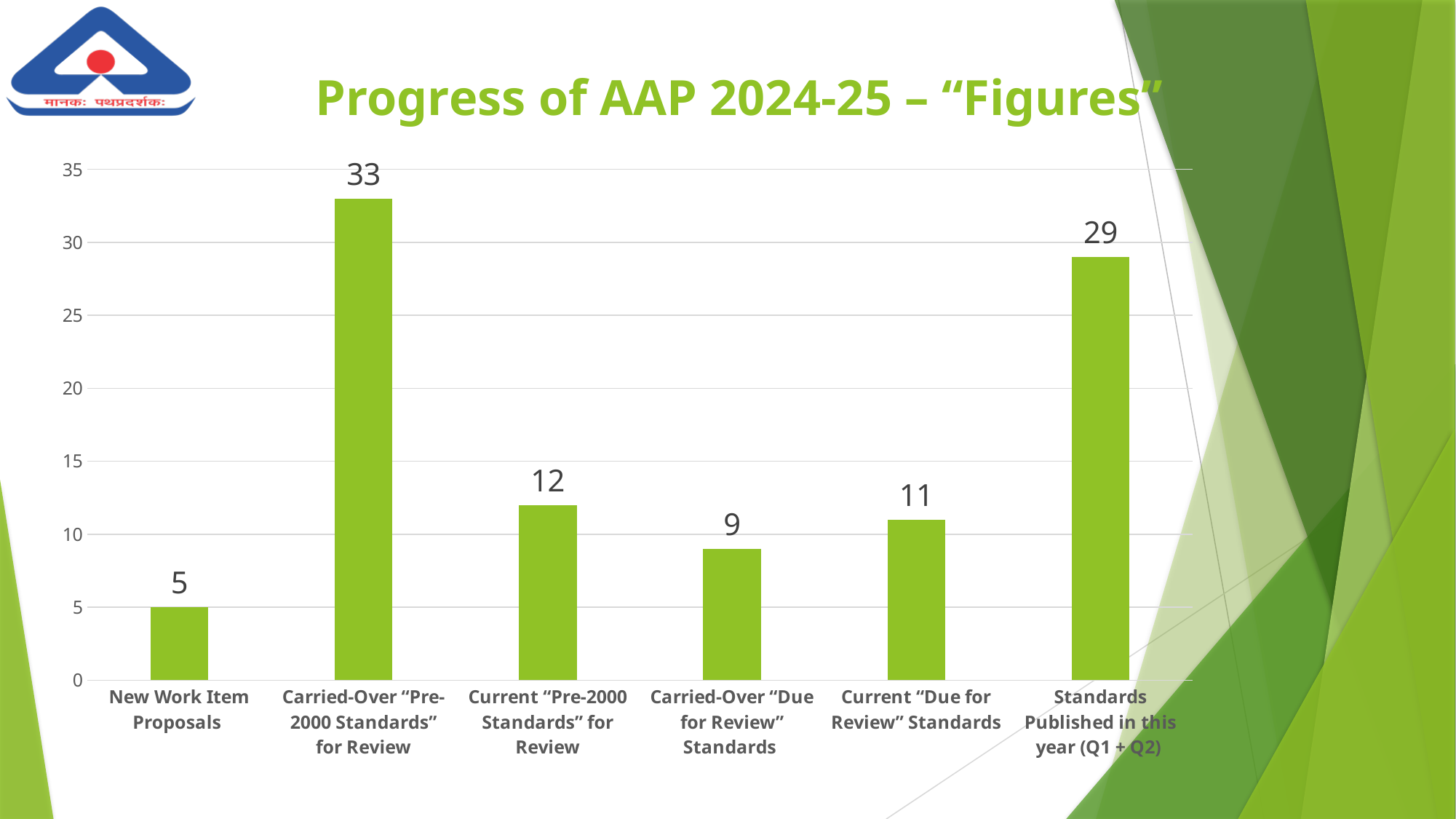
Is the value for Standards Published in this year (Q1 + Q2) greater or less than 25? greater Which is larger: Current "Pre-2000 Standards" for Review or Current "Due for Review" Standards? Current "Pre-2000 Standards" for Review What kind of chart is shown on the slide? Bar chart How many categories are shown on the x axis? 6 What is the value for Standards Published in this year (Q1 + Q2)? 29 What is the title of the slide? Progress of AAP 2024-25 – "Figures" What is the difference between Current "Due for Review" Standards and Carried-Over "Due for Review" Standards? 2 Which category has the lowest value? New Work Item Proposals What is the value for New Work Item Proposals? 5 Which category has the highest value? Carried-Over "Pre-2000 Standards" for Review What is the difference between Carried-Over "Pre-2000 Standards" for Review and Current "Pre-2000 Standards" for Review? 21 What is the value for Carried-Over "Due for Review" Standards? 9